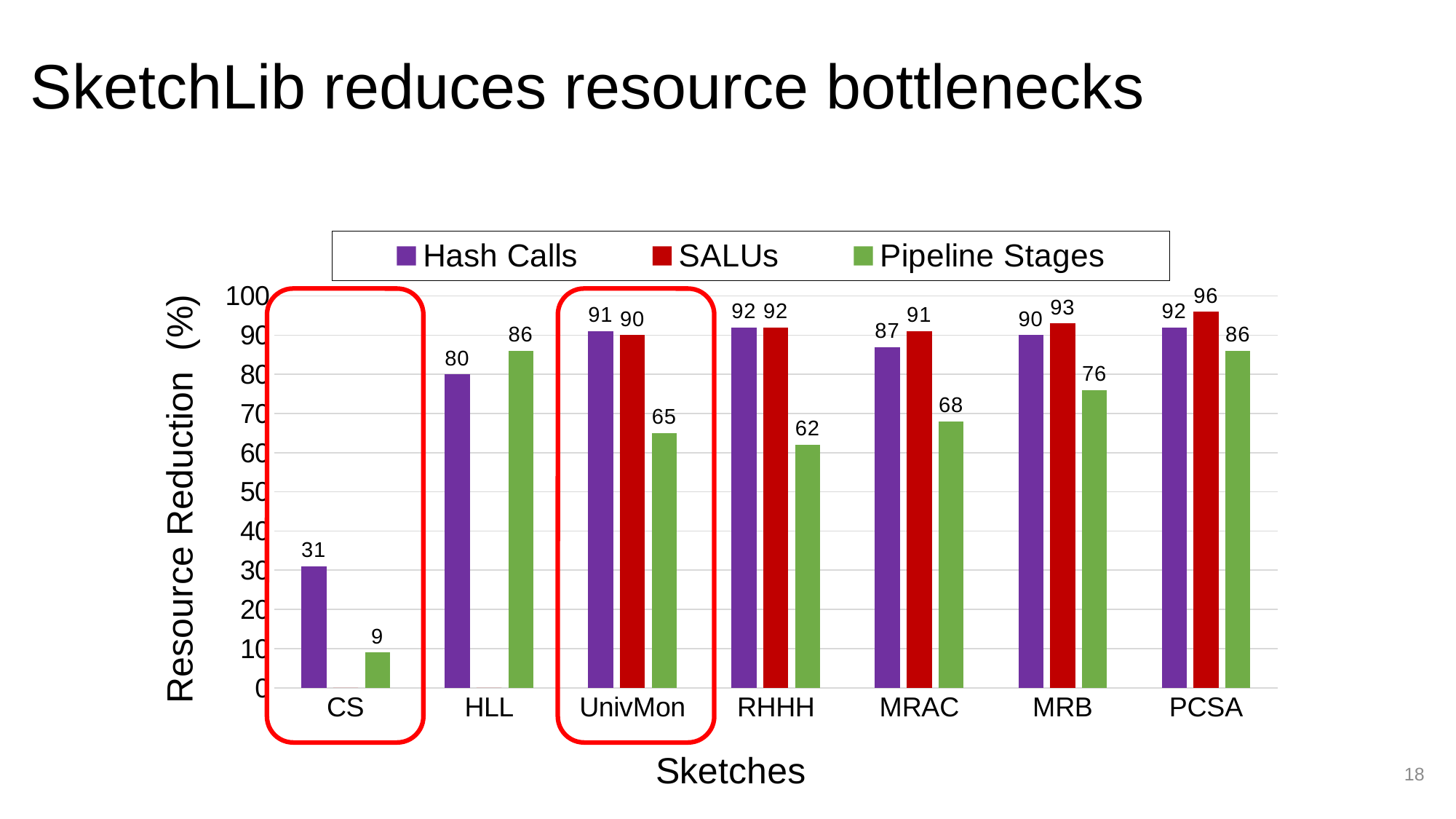
What is the Pipeline Stages resource reduction for UnivMon? 65 Which is larger for MRB: the Hash Calls reduction or the SALUs reduction? SALUs What is the difference between the Pipeline Stages reduction for HLL and for RHHH? 24 What is the SALUs resource reduction for PCSA? 96 What kind of chart is shown on the slide? bar chart What is the Hash Calls resource reduction for CS? 31 How many sketches are shown on the x axis? 7 What is the label of the y axis? Resource Reduction (%) Is the Pipeline Stages value for MRAC greater or less than 60? greater Which sketch has the lowest Pipeline Stages resource reduction? CS Which sketch has the highest SALUs resource reduction? PCSA How many series does the legend list? 3